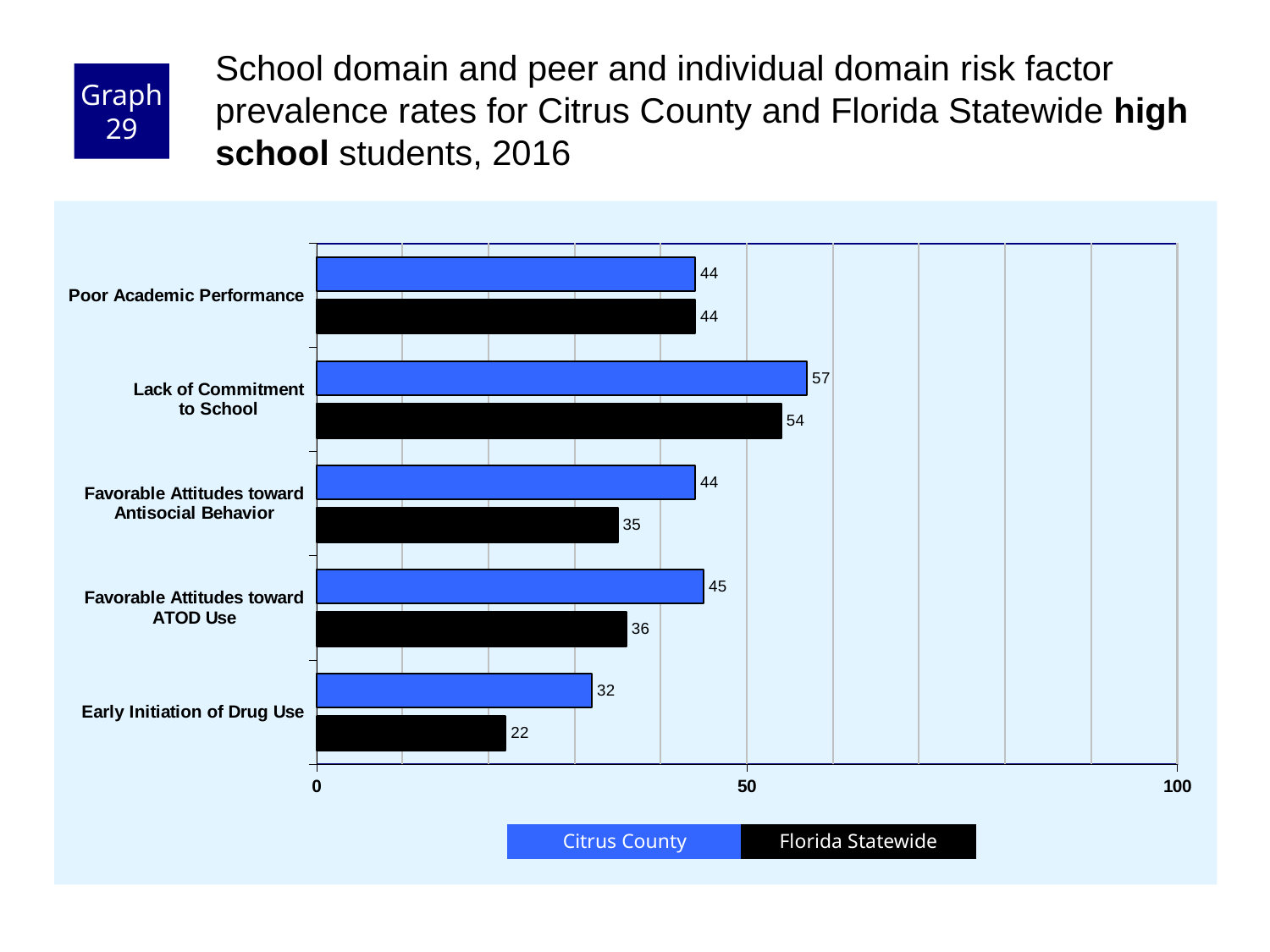
What is the Florida Statewide value for Favorable Attitudes toward Antisocial Behavior? 35 Which is larger for Favorable Attitudes toward Antisocial Behavior: the Citrus County value or the Florida Statewide value? Citrus County What is the Florida Statewide value for Early Initiation of Drug Use? 22 How many series does the legend list? 2 What is the Citrus County value for Lack of Commitment to School? 57 Which category has the highest Citrus County value? Lack of Commitment to School How many risk factor categories are shown on the chart? 5 What kind of chart is shown on the slide? bar chart What is the difference between the Citrus County and Florida Statewide values for Favorable Attitudes toward ATOD Use? 9 What is the difference between the Citrus County and Florida Statewide values for Early Initiation of Drug Use? 10 Is the Citrus County value for Lack of Commitment to School greater or less than 50? greater Which category has the lowest Florida Statewide value? Early Initiation of Drug Use